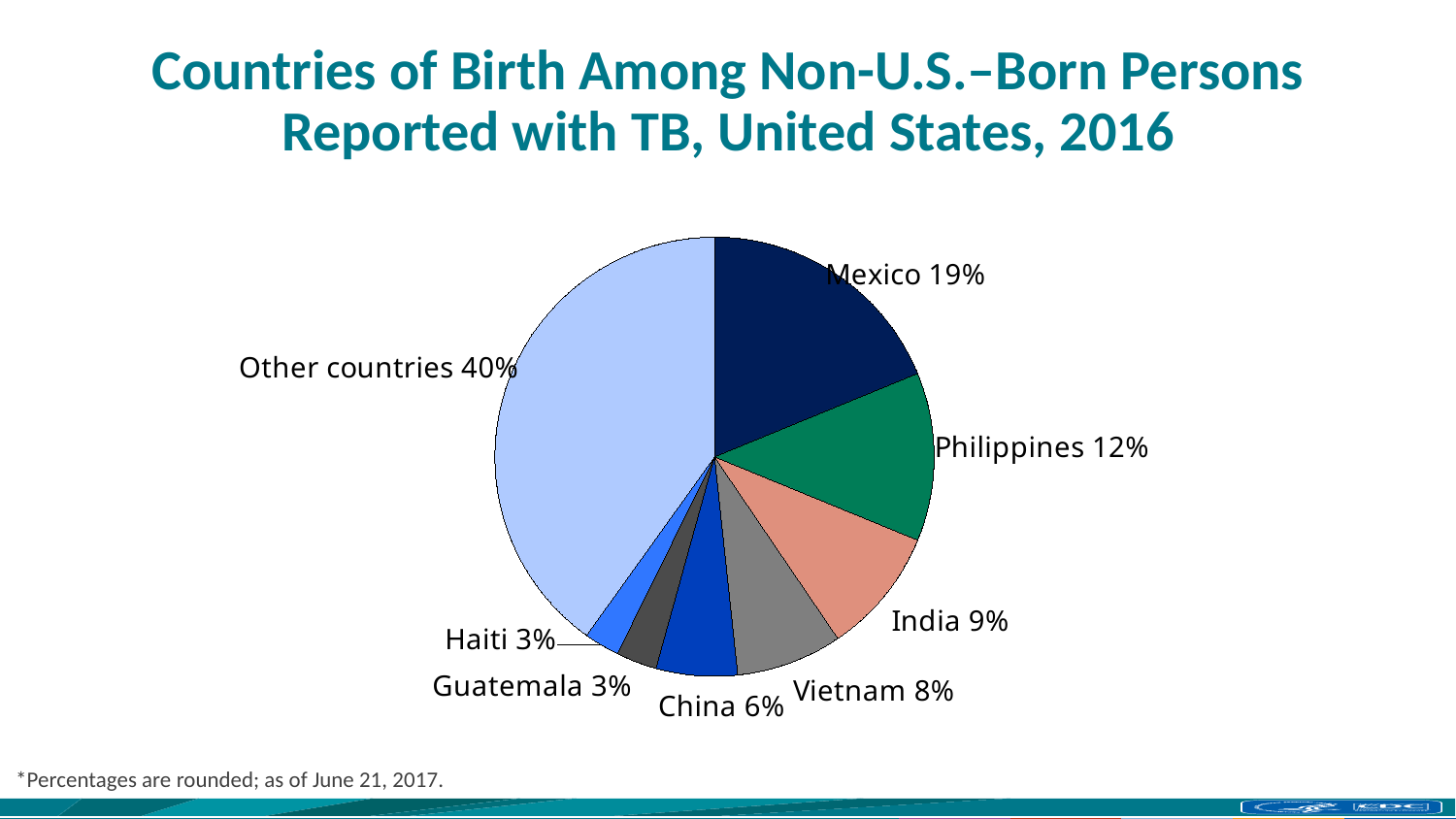
What is the difference in percentage points between Mexico and the Philippines? 7 How many slices does the pie chart have? 8 What percentage of non-U.S.-born persons reported with TB were born in Mexico? 19% What percentage is shown for India? 9% What share of the pie is labelled Philippines? 12% What is the title of the chart? Countries of Birth Among Non-U.S.-Born Persons Reported with TB, United States, 2016 Which slice of the pie is the largest? Other countries What kind of chart is shown on the slide? Pie chart Which single named country has the largest share? Mexico What percentage is shown for Vietnam? 8% What percentage is shown for China? 6% Which is larger, the share for India or the share for Vietnam? India